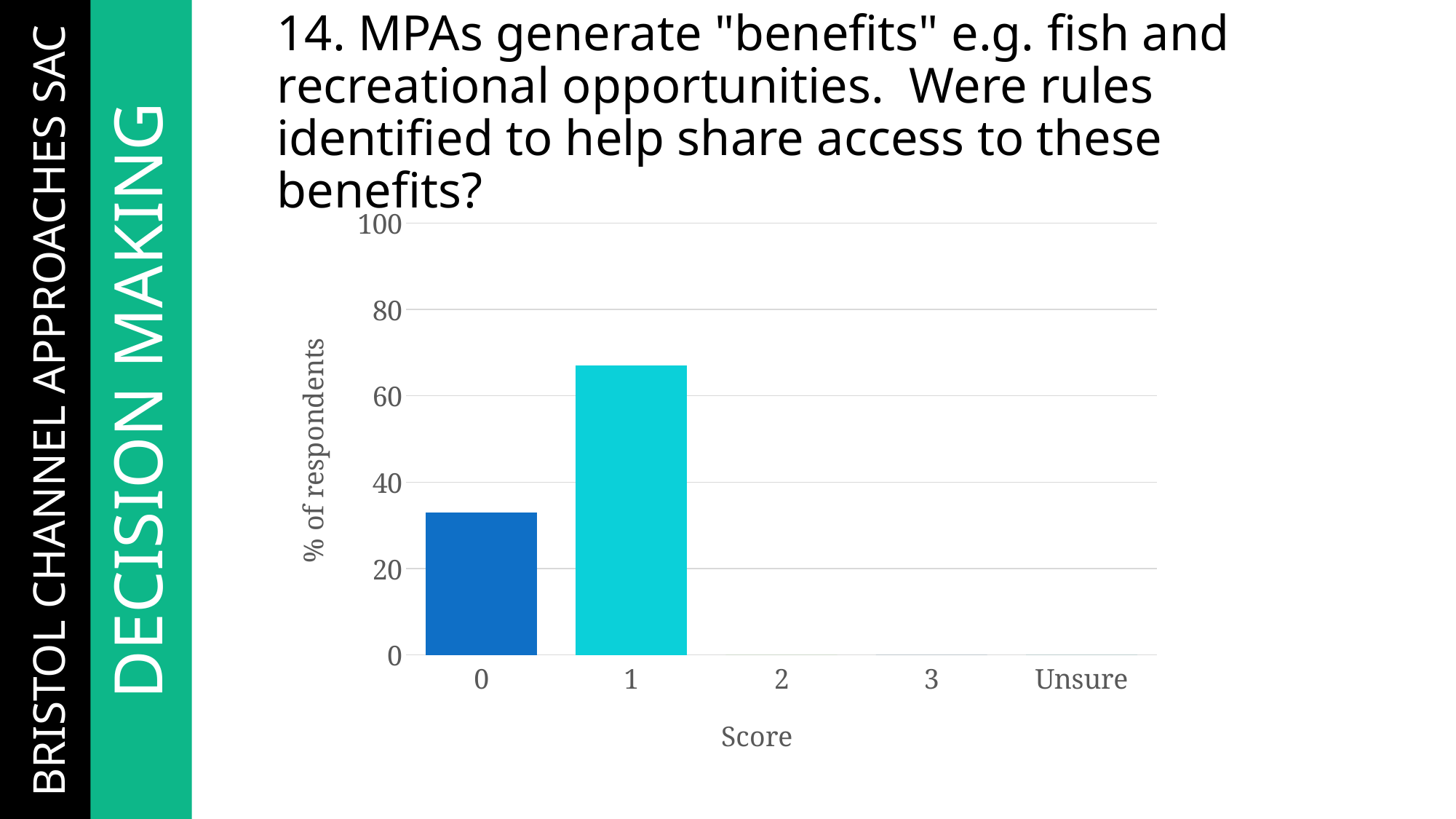
What is the label of the y axis? % of respondents Is the value for score 0 greater or less than 40? less Is the value for score 1 greater or less than 80? less What percentage of respondents answered Unsure? 0 Which is larger, the value for score 0 or the value for score 1? 1 What is the label of the x axis? Score How many score categories are shown on the x axis? 5 Which score category has the highest percentage of respondents? 1 What kind of chart is shown on the slide? bar chart Is the value for score 0 greater or less than 20? greater What percentage of respondents gave a score of 2? 0